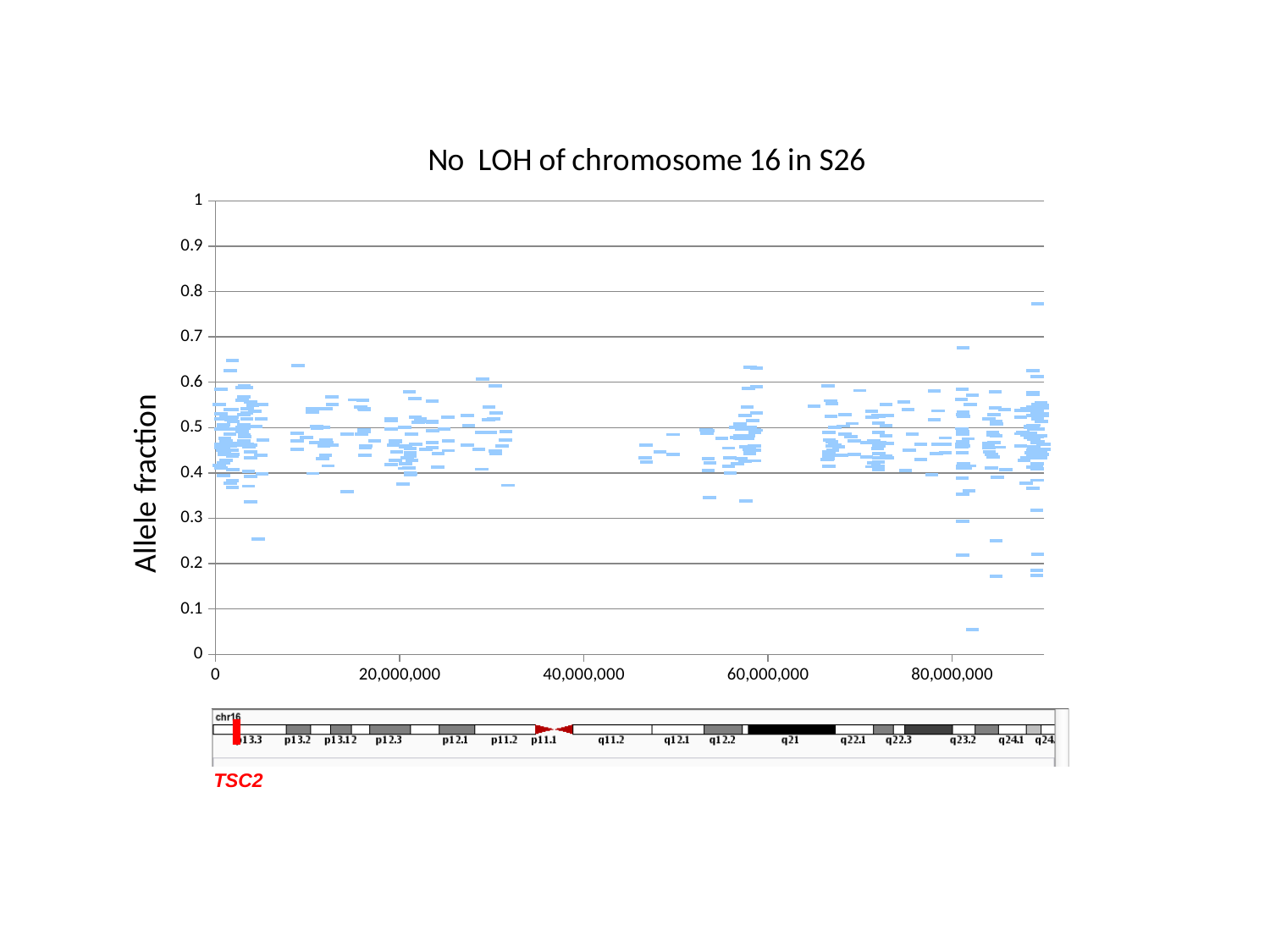
What is the label on the y axis of the chart? Allele fraction Is the highest plotted allele fraction greater or less than 0.7? greater Around which y-axis value do most of the plotted points cluster? 0.5 What is the largest labelled tick value on the x axis? 80,000,000 What is the title of the chart? No LOH of chromosome 16 in S26 Is the lowest plotted allele fraction greater or less than 0.1? less What kind of chart is shown on the slide? scatter plot What is the spacing between consecutive tick labels on the y axis? 0.1 Is the allele fraction of the point plotted near 0.25 at about 5,000,000 greater or less than 0.3? less How many labelled tick values are there on the x axis? 5 What is the maximum value shown on the y axis? 1